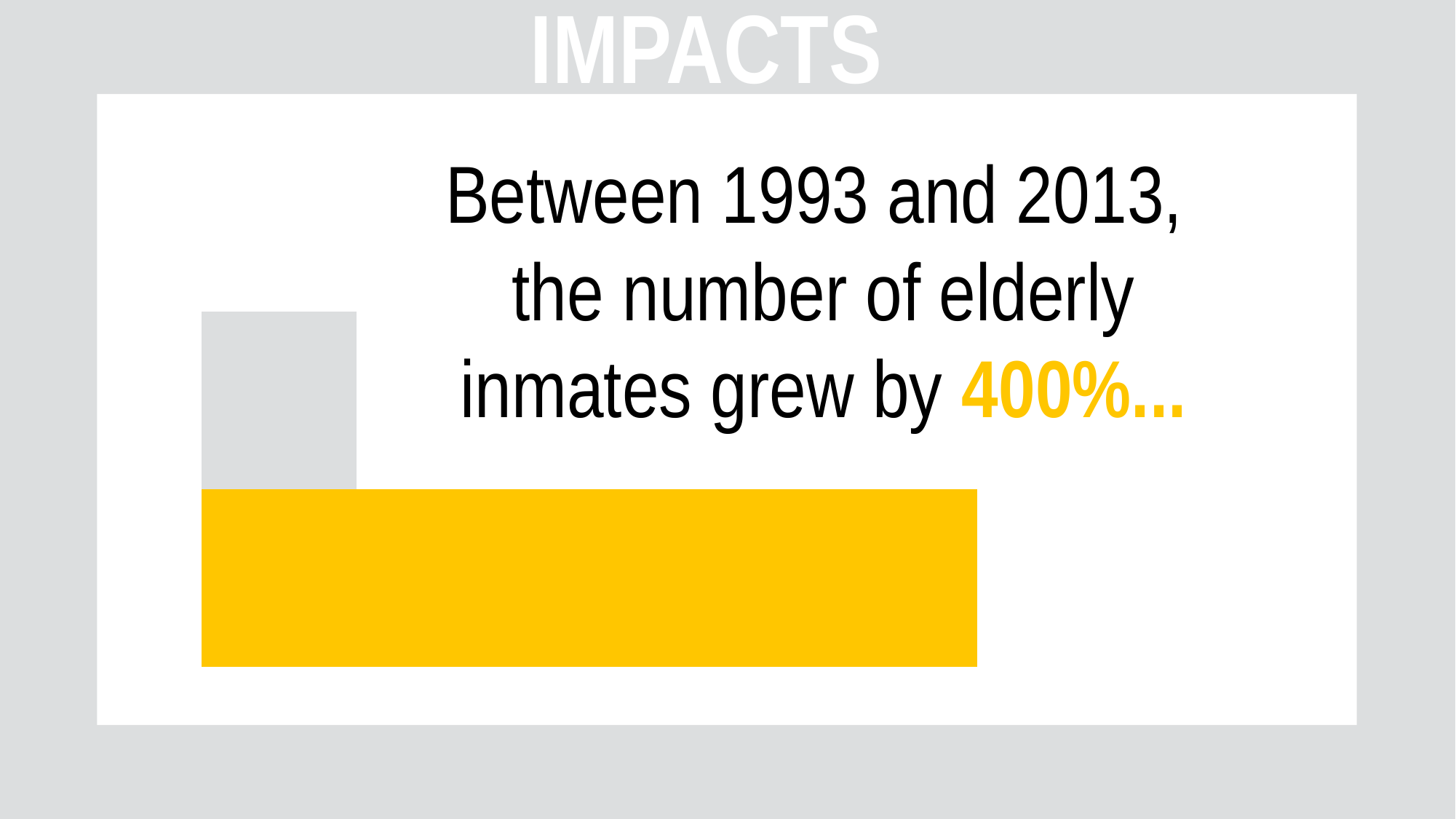
Which bar is longer, the grey bar or the yellow bar? the yellow bar Which bar in the chart is the longest? the yellow bar How many bars does the chart on the slide contain? 2 What is the title shown at the top of the slide? IMPACTS What kind of chart is shown on the slide? bar chart Which bar in the chart is the shortest? the grey bar What colour is the lower, longer bar in the chart? yellow Are the bars in the chart drawn horizontally or vertically? horizontally